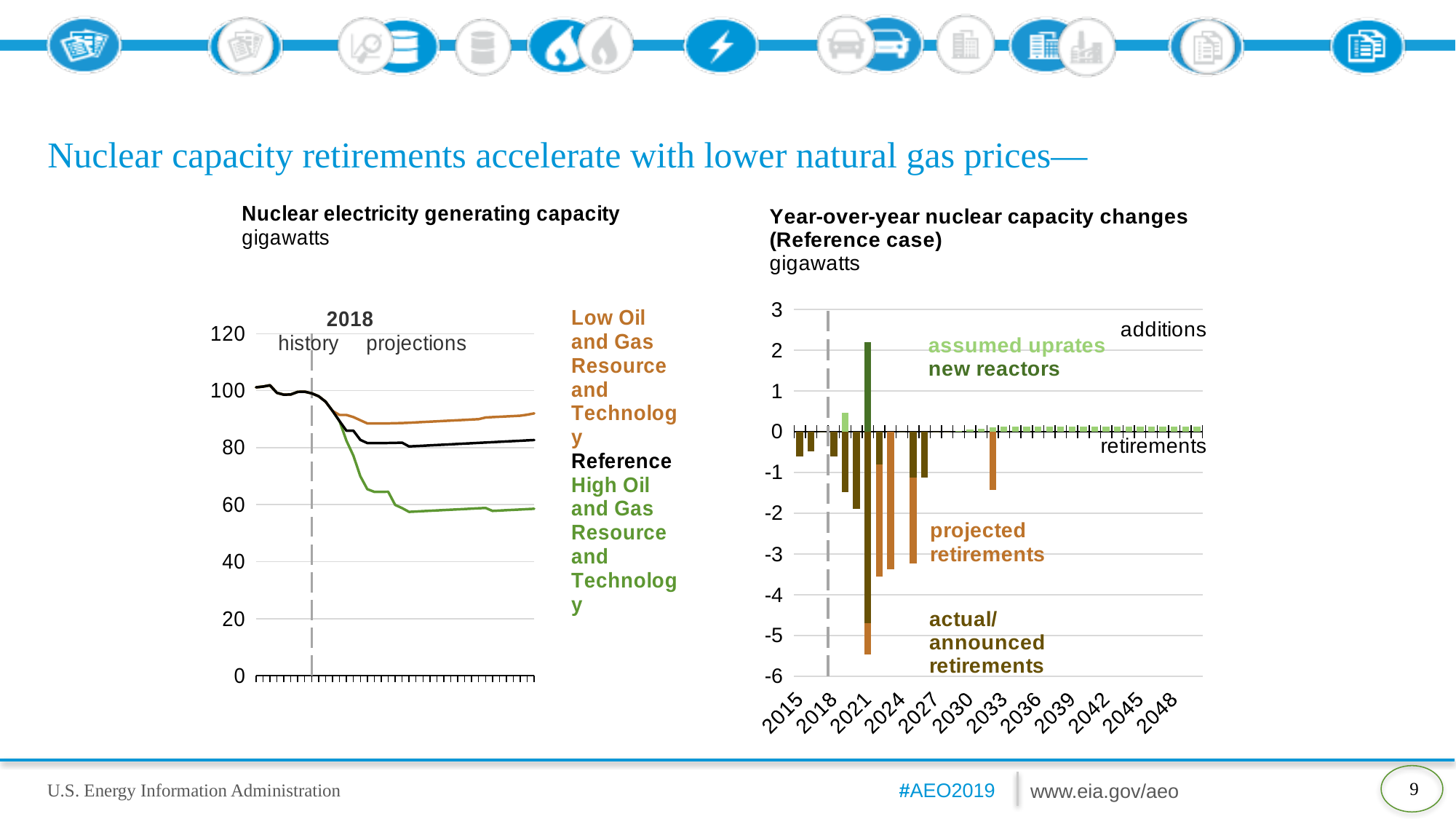
How many categories are labelled in the legend of the 'Year-over-year nuclear capacity changes (Reference case)' chart? 4 What kind of chart is the 'Year-over-year nuclear capacity changes (Reference case)' chart on the right? Bar chart On the 'Nuclear electricity generating capacity' chart, at the end of the projection, which is larger: the Reference line or the High Oil and Gas Resource and Technology line? Reference What kind of chart is the 'Nuclear electricity generating capacity' chart on the left? Line chart On the 'Nuclear electricity generating capacity' chart, which series is highest at the end of the projection period? Low Oil and Gas Resource and Technology On the 'Nuclear electricity generating capacity' chart, which series is lowest at the end of the projection period? High Oil and Gas Resource and Technology On the 'Nuclear electricity generating capacity' chart, is the Low Oil and Gas Resource and Technology value at the end of the projection greater or less than 100? less On the 'Nuclear electricity generating capacity' chart, does the Reference line rise or fall over the projection period? Fall How many year labels are shown on the x axis of the 'Year-over-year nuclear capacity changes (Reference case)' chart? 12 On the 'Year-over-year nuclear capacity changes (Reference case)' chart, is the bottom of the largest negative bar (around 2021) greater or less than -5? less How many series are labelled on the 'Nuclear electricity generating capacity' chart? 3 On the 'Nuclear electricity generating capacity' chart, which year does the dashed vertical line separating history from projections mark? 2018